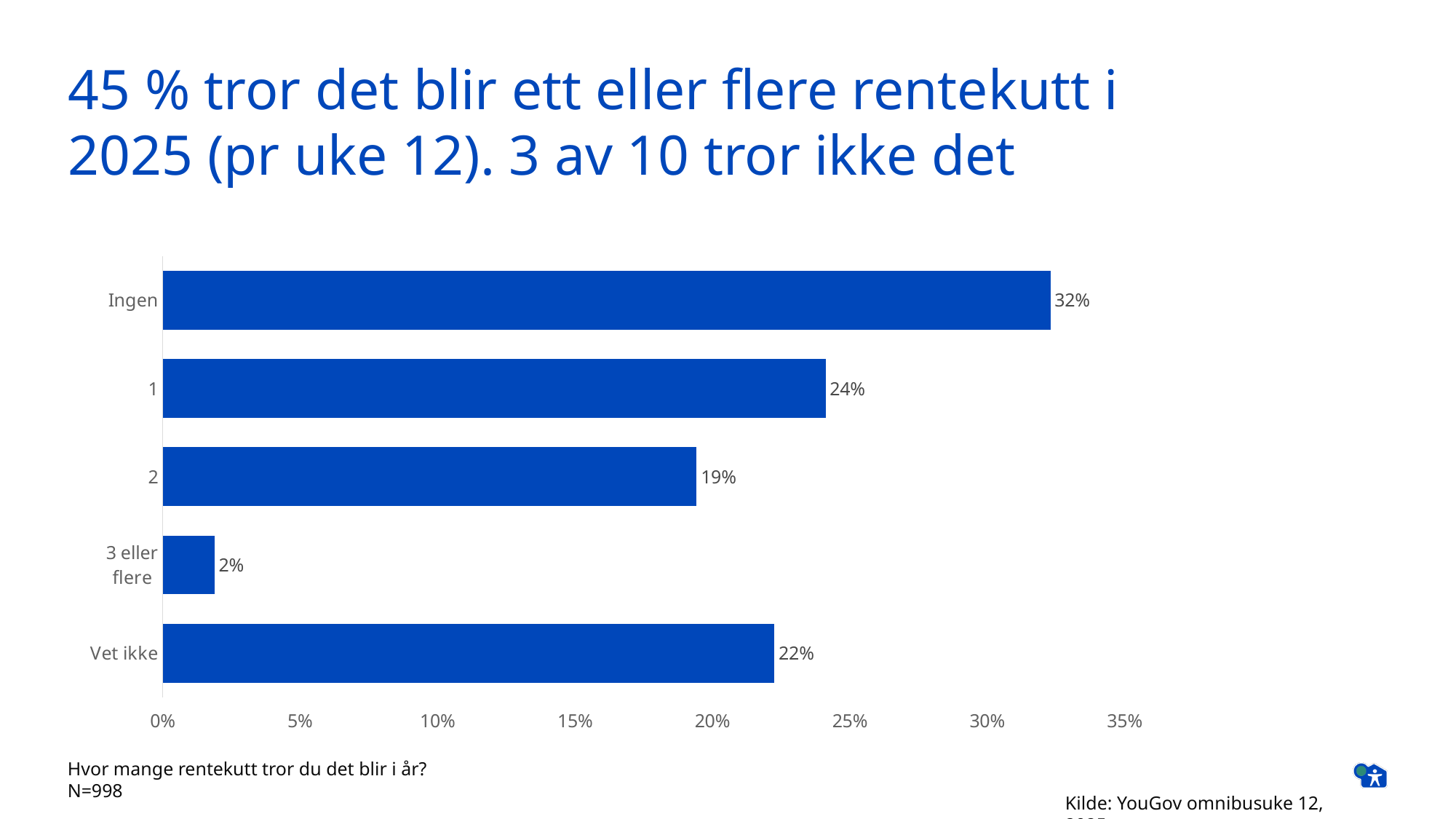
What is the value for "3 eller flere"? 2% How many categories are shown in the chart? 5 Which is larger, the value for "2" or the value for "Vet ikke"? Vet ikke Which category has the highest value? Ingen What is the value for the category "1"? 24% What is the difference between the values for "Ingen" and "1"? 8% Which category has the lowest value? 3 eller flere What is the sample size (N) stated below the chart? N=998 What percentage of respondents answered "Ingen"? 32% Is the value for "Ingen" greater or less than 30%? greater What is the value for "Vet ikke"? 22% What kind of chart is shown on the slide? Bar chart